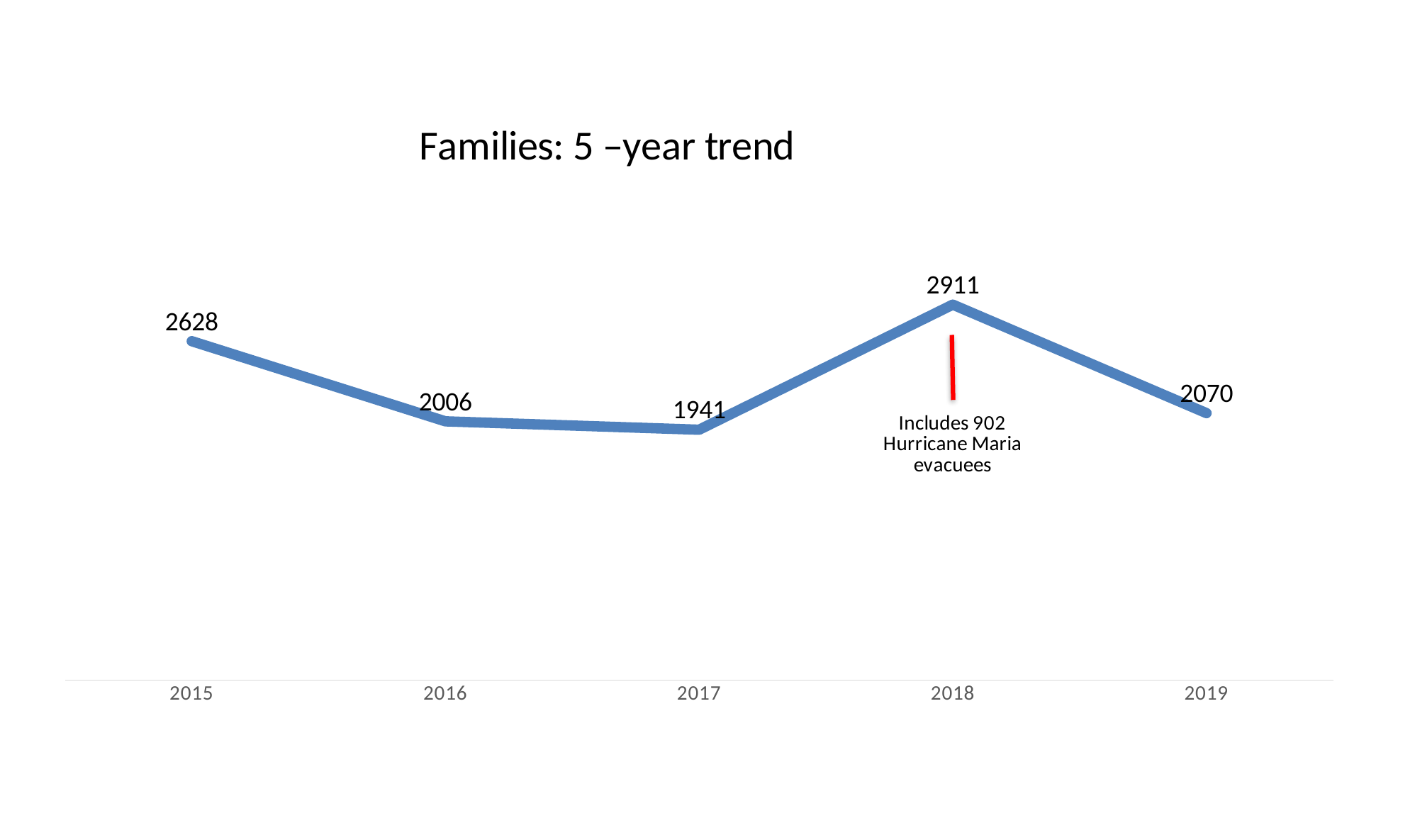
What is the difference between the values for 2018 and 2017? 970 What is the value for 2015? 2628 Which is larger, the value for 2015 or the value for 2019? 2015 What kind of chart is shown? line chart What is the value for 2019? 2070 Do the values rise or fall from 2018 to 2019? fall What is the difference between the values for 2015 and 2016? 622 What is the title of the chart? Families: 5 –year trend Which year has the lowest value? 2017 Which year has the highest value? 2018 What is the value for 2017? 1941 How many years are plotted on the chart? 5